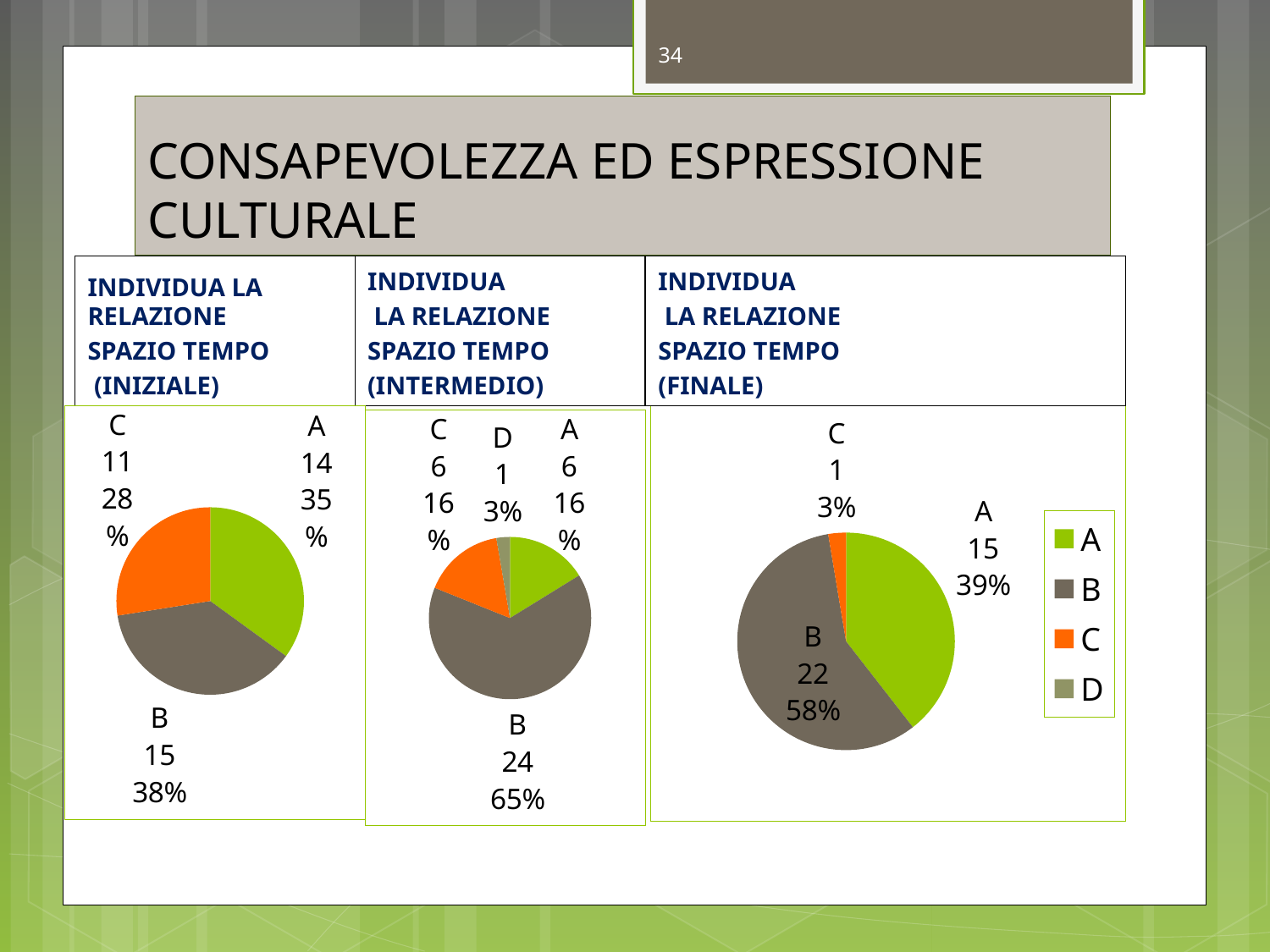
In the INIZIALE pie chart (left), what is the value for B? 15 How many entries does the legend of the FINALE chart (right) list? 4 In the FINALE pie chart (right), what percentage share does B have? 58% In the FINALE pie chart (right), what is the value for A? 15 In the INIZIALE pie chart (left), which category has the largest slice? B In the INTERMEDIO pie chart (middle), what is the difference between the values for B and A? 18 In the INTERMEDIO pie chart (middle), what is the value for B? 24 In the INIZIALE pie chart (left), how many slices are there? 3 In the FINALE pie chart (right), which is larger, the value for A or the value for C? A In the INIZIALE pie chart (left), what percentage share does C have? 28% In the INTERMEDIO pie chart (middle), which category has the smallest slice? D In the INTERMEDIO pie chart (middle), what percentage share does D have? 3%